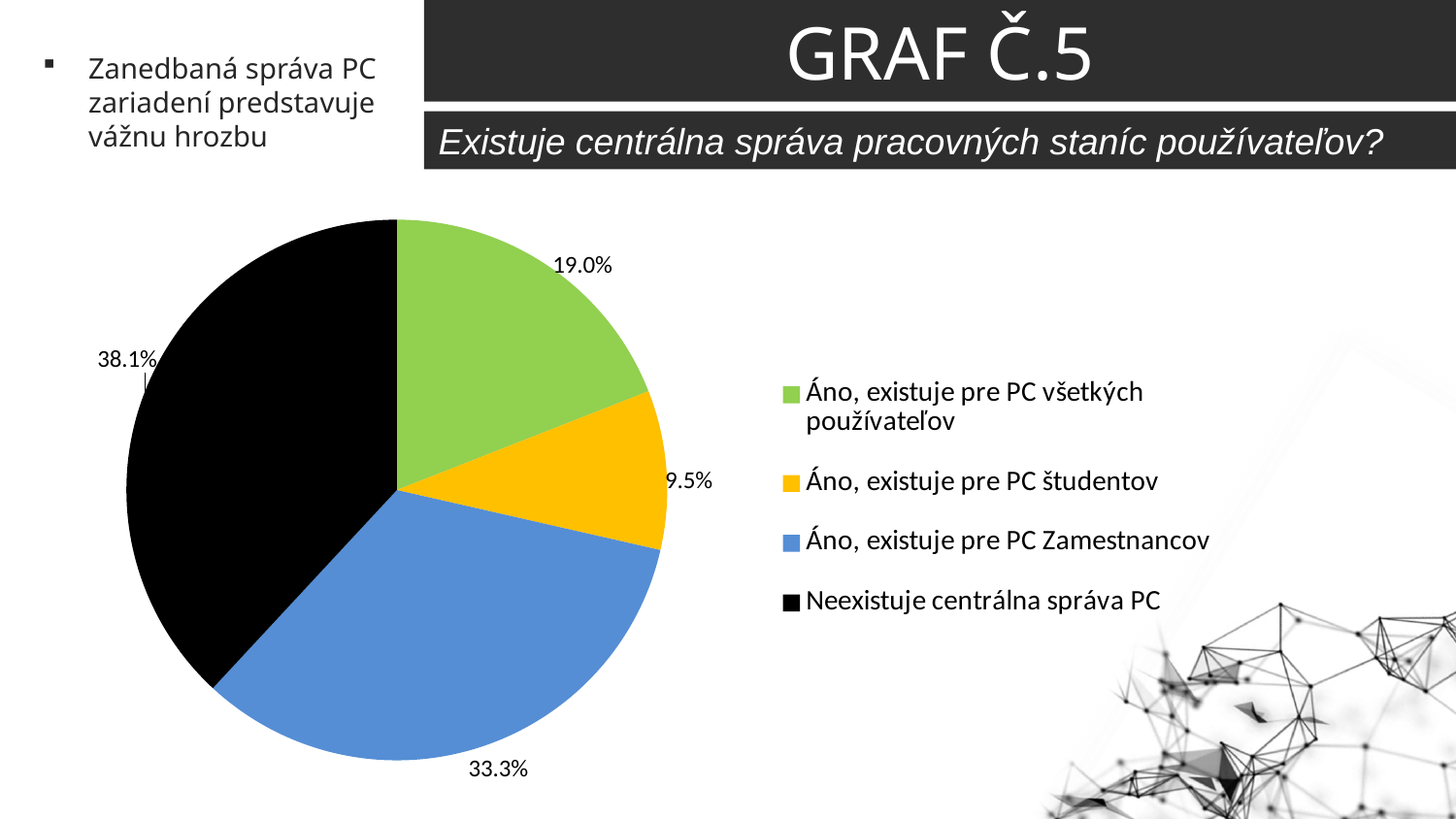
What share of the pie is labelled "Áno, existuje pre PC všetkých používateľov"? 19.0% What is the difference in percentage points between "Neexistuje centrálna správa PC" and "Áno, existuje pre PC Zamestnancov"? 4.8 What share of the pie is labelled "Neexistuje centrálna správa PC"? 38.1% What share of the pie is labelled "Áno, existuje pre PC študentov"? 9.5% Which category has the smallest slice of the pie? Áno, existuje pre PC študentov What question is shown as the subtitle of the chart? Existuje centrálna správa pracovných staníc používateľov? How many slices does the pie chart have? 4 Which is larger: the slice for "Áno, existuje pre PC všetkých používateľov" or the slice for "Áno, existuje pre PC študentov"? Áno, existuje pre PC všetkých používateľov Which category has the largest slice of the pie? Neexistuje centrálna správa PC What share of the pie is labelled "Áno, existuje pre PC Zamestnancov"? 33.3% What kind of chart is shown on the slide? pie chart What colour is the slice for "Neexistuje centrálna správa PC"? black